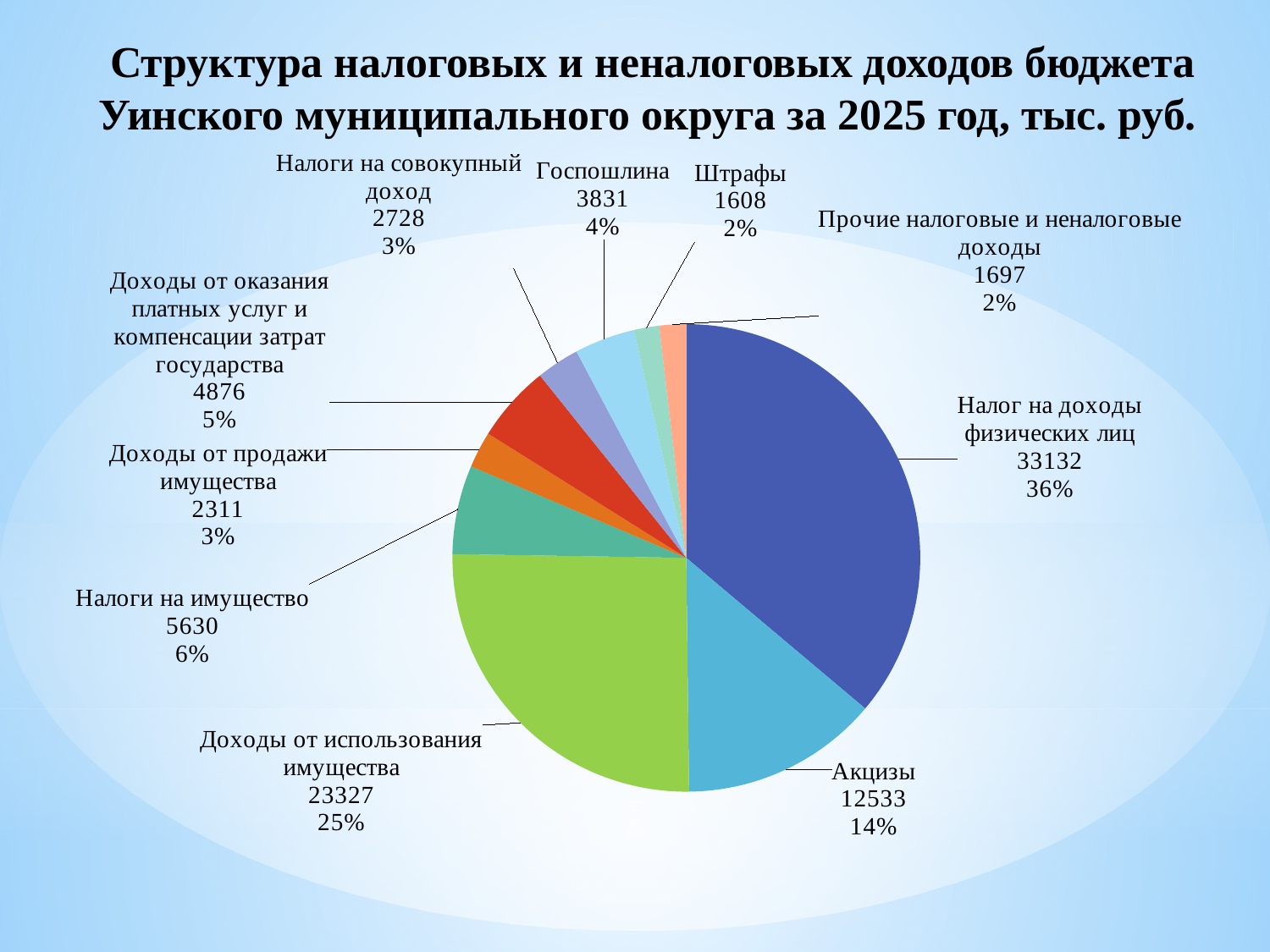
What kind of chart is shown on the slide? pie chart What share of the pie does Налоги на имущество represent? 6% What share of the pie does Акцизы represent? 14% What is the value for Налог на доходы физических лиц? 33132 How many slices does the pie chart have? 10 What year does the chart title say the data is for? 2025 What is the value for Доходы от использования имущества? 23327 Which is larger: the value for Доходы от оказания платных услуг и компенсации затрат государства or the value for Налоги на совокупный доход? Доходы от оказания платных услуг и компенсации затрат государства Which category has the smallest slice of the pie? Штрафы Which category has the largest slice of the pie? Налог на доходы физических лиц What is the difference between the values for Налог на доходы физических лиц and Доходы от использования имущества? 9805 What is the value for Госпошлина? 3831